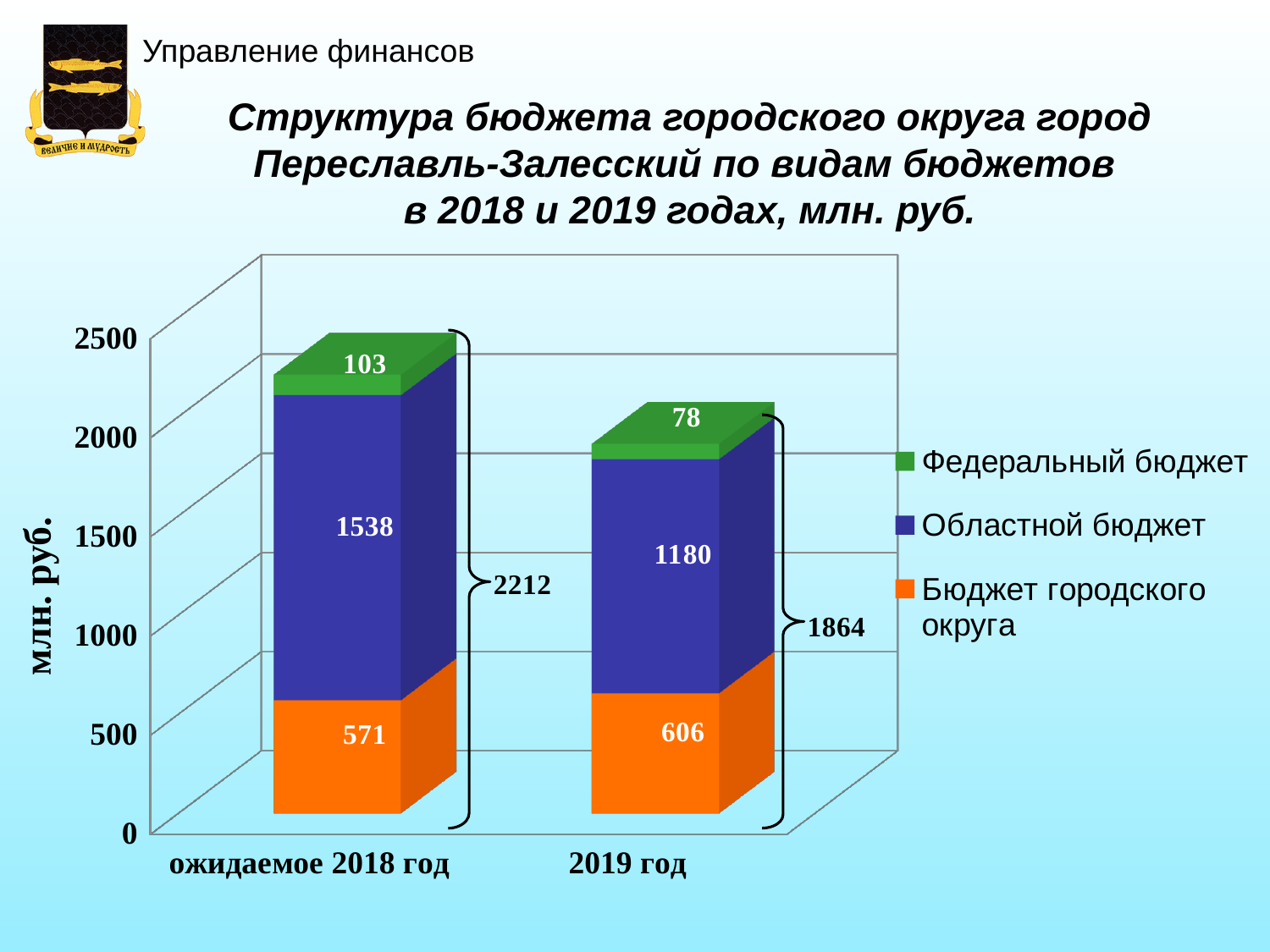
Which is larger: Бюджет городского округа for ожидаемое 2018 год or for 2019 год? 2019 год What is the value of Областной бюджет for ожидаемое 2018 год? 1538 What is the value of Бюджет городского округа for 2019 год? 606 How many categories are shown on the x axis? 2 What is the difference between the Областной бюджет values for ожидаемое 2018 год and 2019 год? 358 How many series does the legend list? 3 What is the label of the vertical axis? млн. руб. What is the value of Федеральный бюджет for 2019 год? 78 What is the total of the stacked bar for ожидаемое 2018 год? 2212 Which category has the higher total: ожидаемое 2018 год or 2019 год? ожидаемое 2018 год What kind of chart is shown on the slide? stacked bar chart What is the total of the stacked bar for 2019 год? 1864